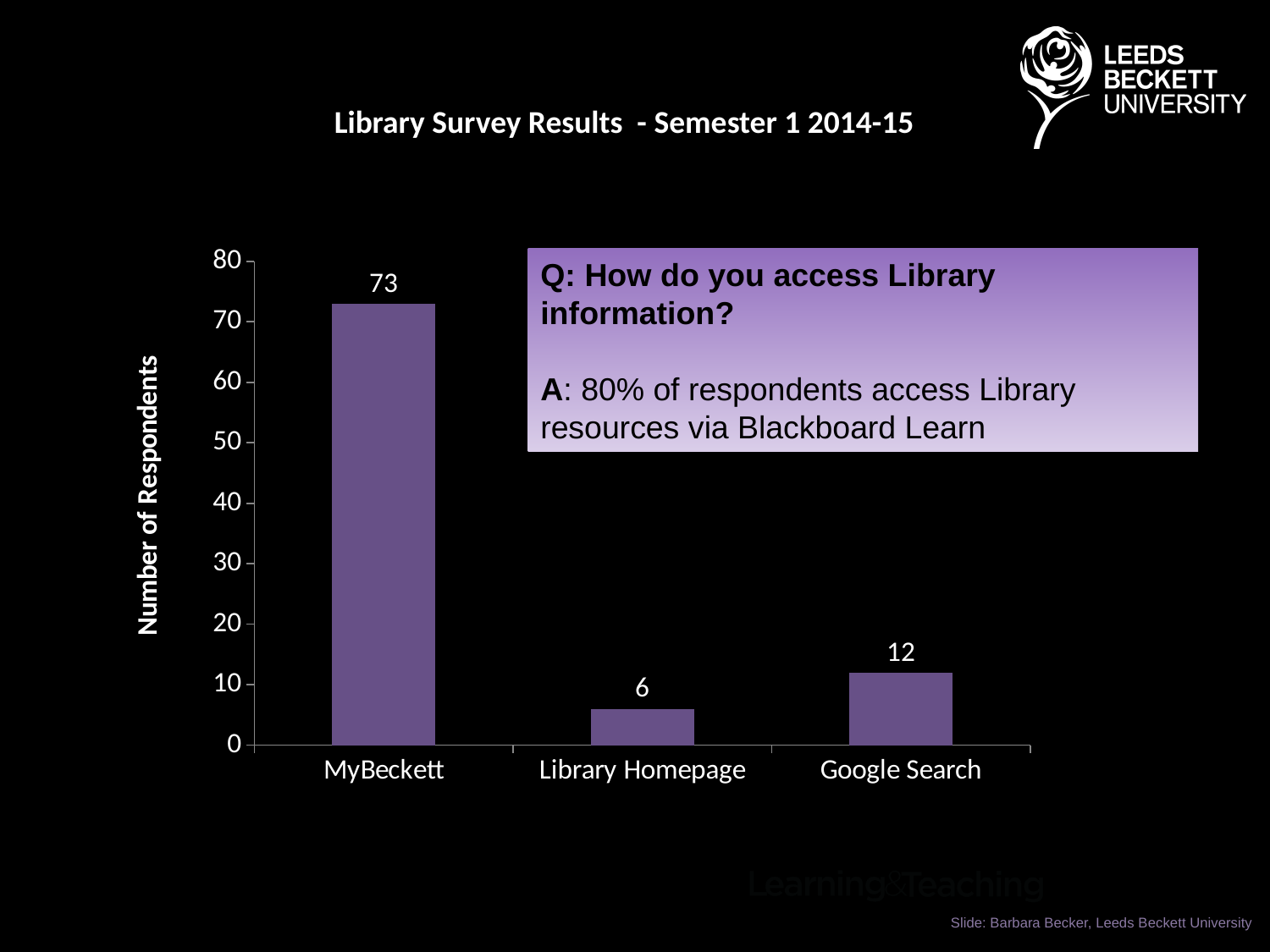
Which access method has the lowest number of respondents? Library Homepage What kind of chart is shown on the slide? bar chart What is the label of the vertical axis? Number of Respondents How many respondents access Library information via Google Search? 12 How many respondents access Library information via MyBeckett? 73 Which access method has the highest number of respondents? MyBeckett What is the difference in respondents between MyBeckett and Google Search? 61 How many access methods are shown on the chart? 3 What is the difference in respondents between Google Search and Library Homepage? 6 Which has more respondents, Google Search or Library Homepage? Google Search How many respondents access Library information via the Library Homepage? 6 Is the value for MyBeckett greater or less than 70? greater